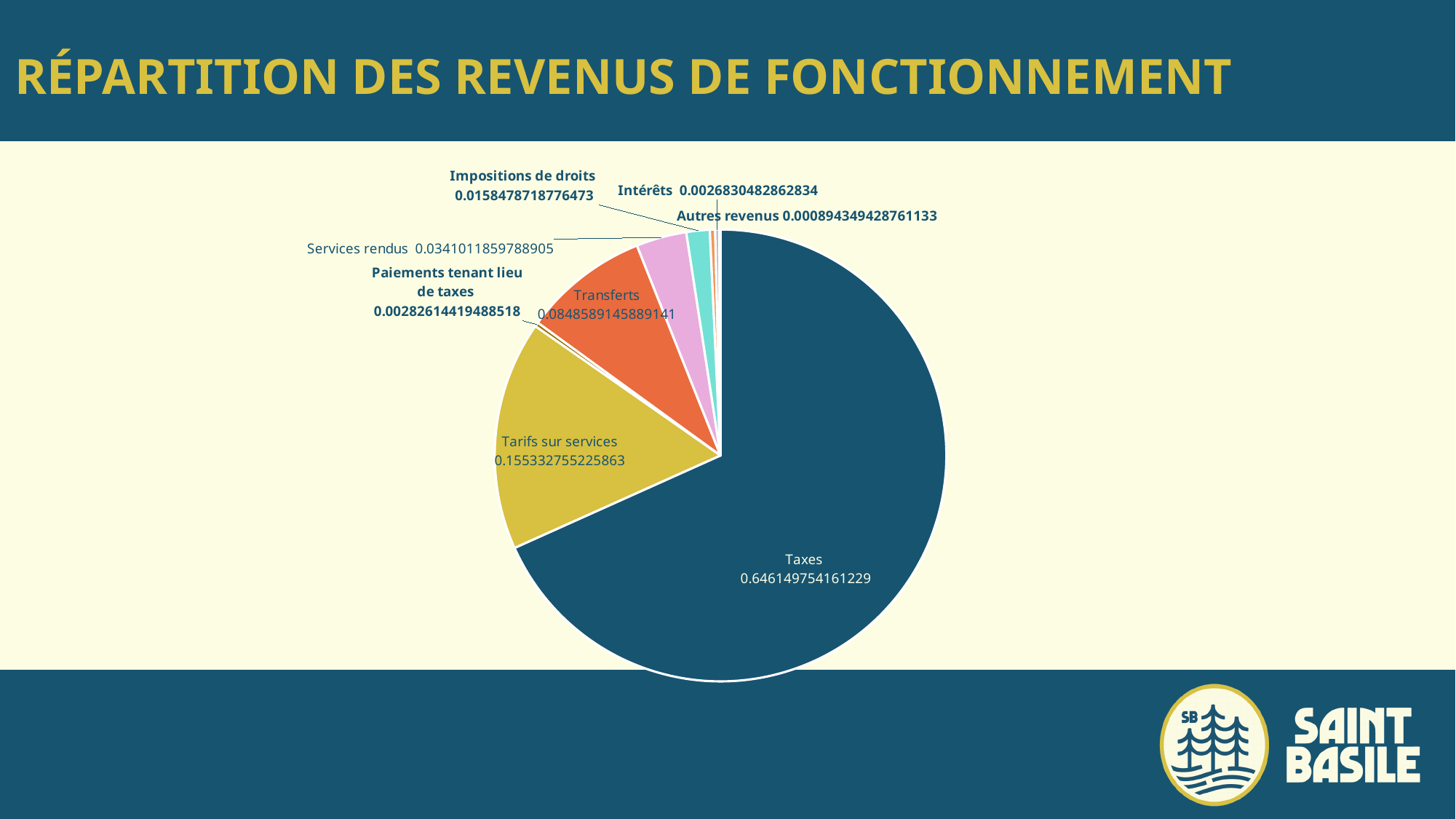
What is the value shown for Impositions de droits? 0.0158478718776473 What is the value shown for Services rendus? 0.0341011859788905 What is the value shown for Autres revenus? 0.000894349428761133 What is the title of the slide containing the pie chart? RÉPARTITION DES REVENUS DE FONCTIONNEMENT Which category has the smallest value in the pie chart? Autres revenus What is the value shown for Tarifs sur services? 0.155332755225863 Which is larger, Tarifs sur services or Transferts? Tarifs sur services How many categories (slices) does the pie chart have? 9 What is the value shown for Taxes? 0.646149754161229 What is the value shown for Transferts? 0.0848589145889141 Which category has the largest slice of the pie? Taxes What kind of chart is shown on the slide? pie chart